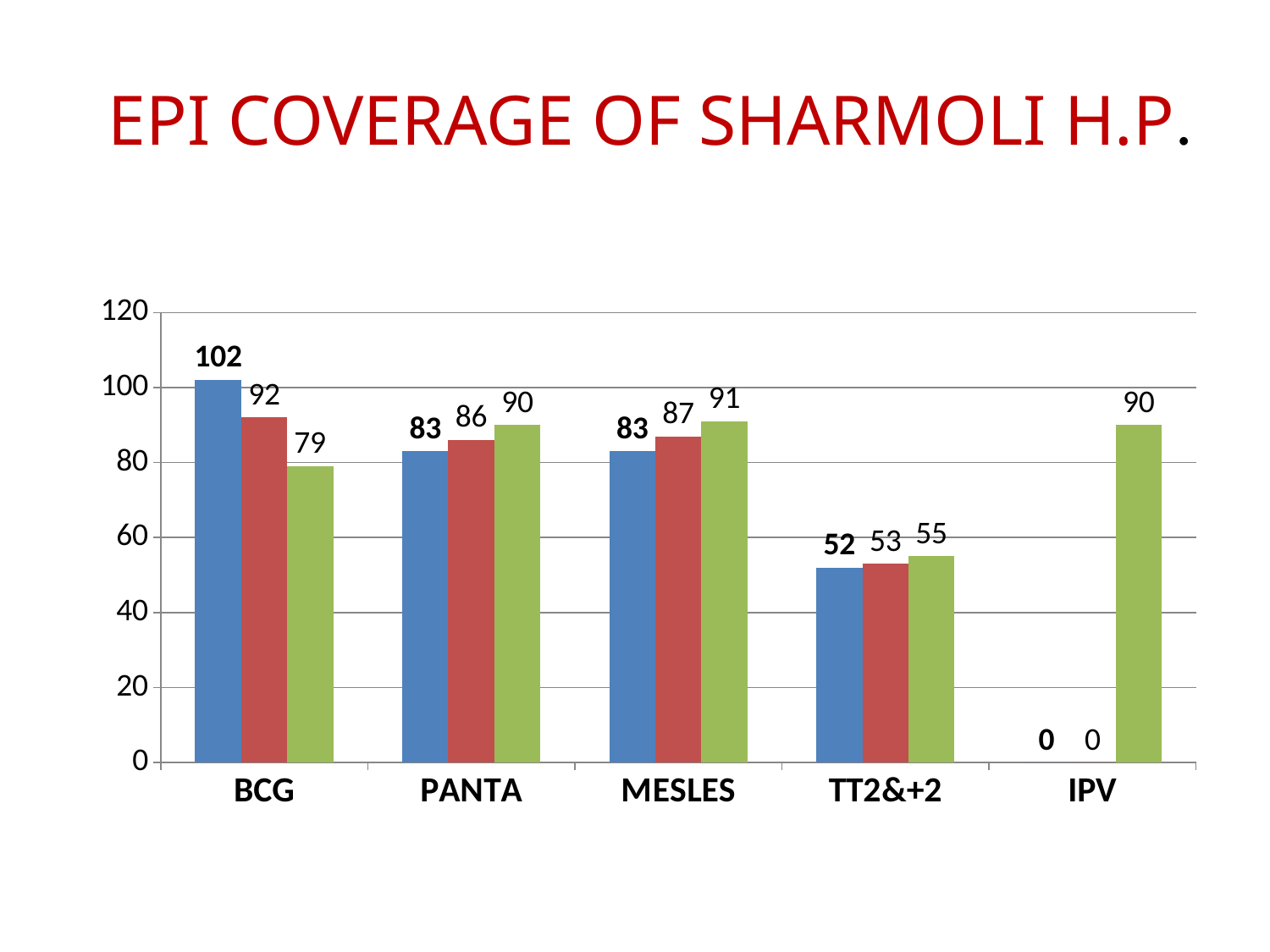
For BCG, which is larger, the blue bar or the green bar? the blue bar Which category has the highest blue bar? BCG What is the title of the slide? EPI COVERAGE OF SHARMOLI H.P. What is the value of the red bar for TT2&+2? 53 What is the difference between the blue bar and the green bar for BCG? 23 What is the value of the red bar for MESLES? 87 How many categories are shown on the x axis? 5 What is the value of the blue bar for BCG? 102 Is the value of the blue bar for TT2&+2 greater or less than 60? less Which category has the lowest red bar? IPV What kind of chart is shown on the slide? bar chart What is the value of the green bar for IPV? 90